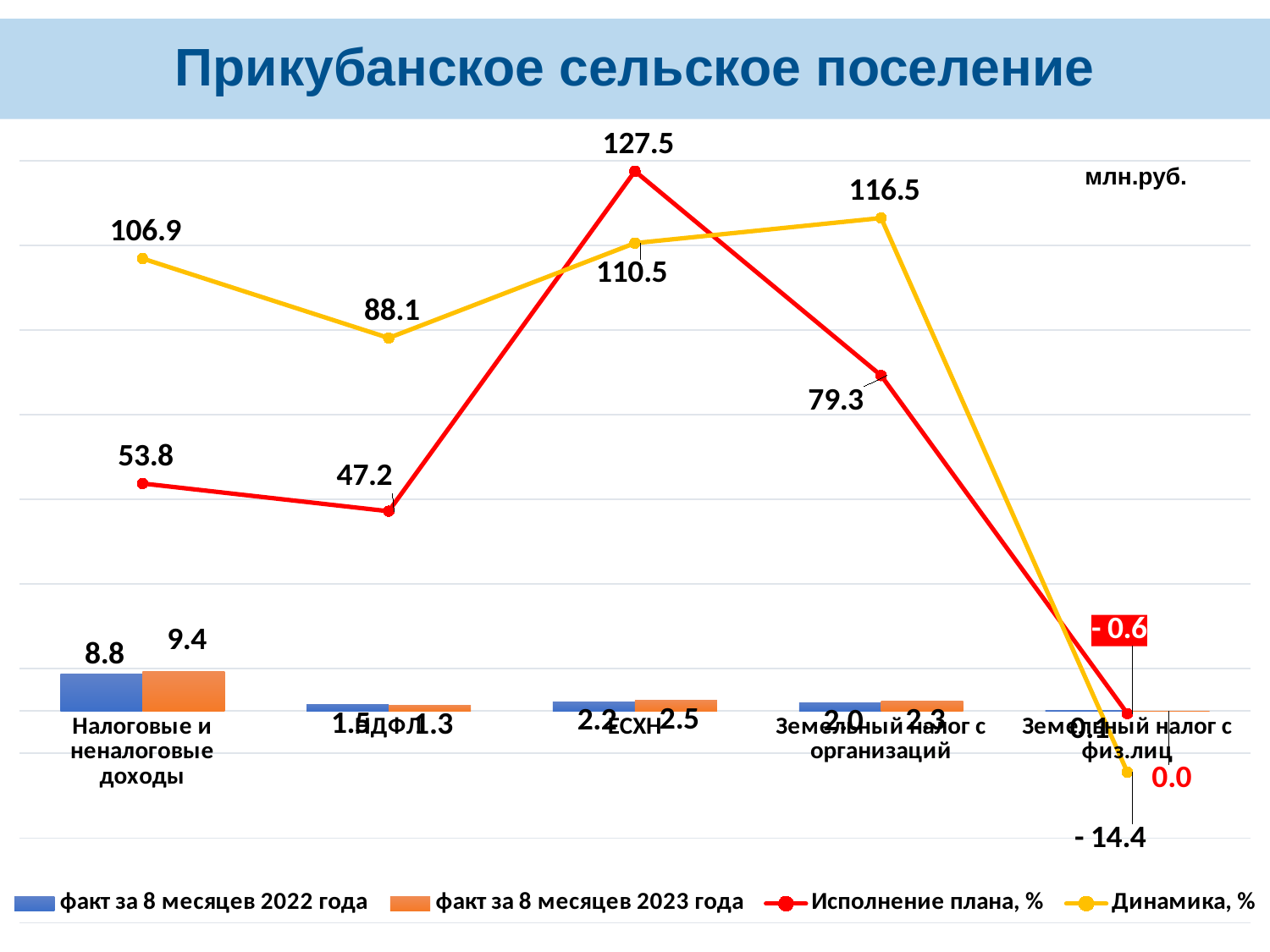
Which has the larger Динамика, % value: Налоговые и неналоговые доходы or НДФЛ? Налоговые и неналоговые доходы For ЕСХН, what is the difference between Исполнение плана, % and Динамика, %? 17.0 Which category has the highest value of Исполнение плана, %? ЕСХН What is the value of Исполнение плана, % for ЕСХН? 127.5 What is the difference between факт за 8 месяцев 2023 года and факт за 8 месяцев 2022 года for Налоговые и неналоговые доходы? 0.6 What is the value of факт за 8 месяцев 2023 года for Налоговые и неналоговые доходы? 9.4 What kind of chart is shown on the slide? Combination bar and line chart What is the value of Динамика, % for Земельный налог с организаций? 116.5 How many series does the legend list? 4 What is the value of Исполнение плана, % for НДФЛ? 47.2 What unit is indicated in the top right of the chart? млн.руб. Which category has the highest value of факт за 8 месяцев 2022 года? Налоговые и неналоговые доходы